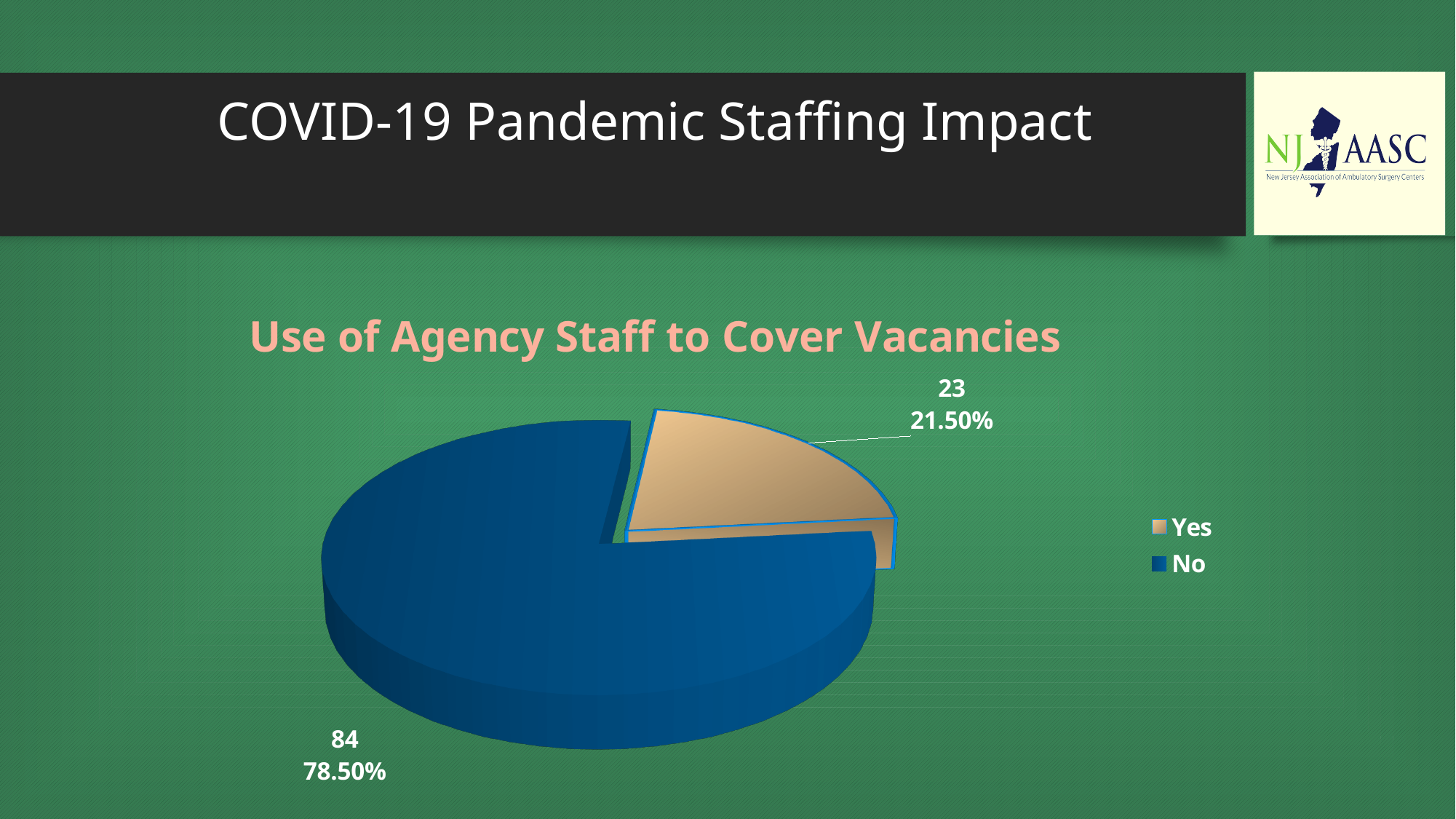
What percentage share does the 'Yes' slice represent? 21.50% What is the count for the 'Yes' slice? 23 Which slice is the smallest? Yes Which slice is the largest? No What is the difference between the 'No' count and the 'Yes' count? 61 Which colour represents the 'Yes' slice in the legend? Tan What is the count for the 'No' slice? 84 What is the title of the chart? Use of Agency Staff to Cover Vacancies How many entries does the legend list? 2 What type of chart is shown on the slide? Pie chart What percentage share does the 'No' slice represent? 78.50% How many slices does the pie chart have? 2